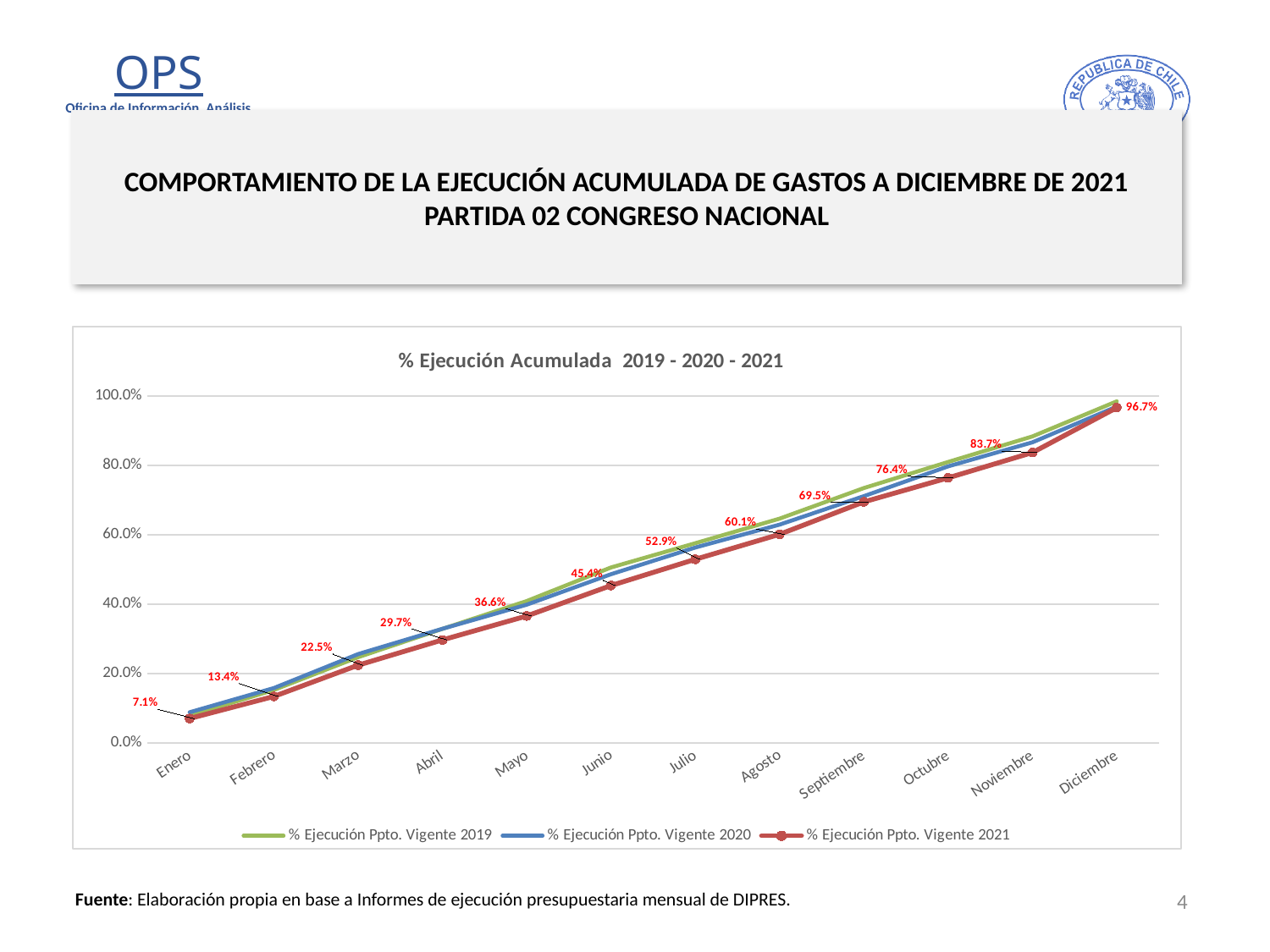
What is the value for % Ejecución Ppto. Vigente 2021 in Junio? 45.4% What is the value for % Ejecución Ppto. Vigente 2021 in Enero? 7.1% How many series does the legend list? 3 What type of chart is shown on the slide? line chart Do the % Ejecución Ppto. Vigente 2021 values rise or fall from Enero to Diciembre? rise What is the difference between the % Ejecución Ppto. Vigente 2021 values for Diciembre and Noviembre? 13.0% What is the value for % Ejecución Ppto. Vigente 2021 in Diciembre? 96.7% What is the value for % Ejecución Ppto. Vigente 2021 in Septiembre? 69.5% How many months are shown on the x axis? 12 What is the title of the chart? % Ejecución Acumulada 2019 - 2020 - 2021 In which month is the % Ejecución Ppto. Vigente 2021 value lowest? Enero Is the value for % Ejecución Ppto. Vigente 2019 in Marzo greater or less than 40.0%? less